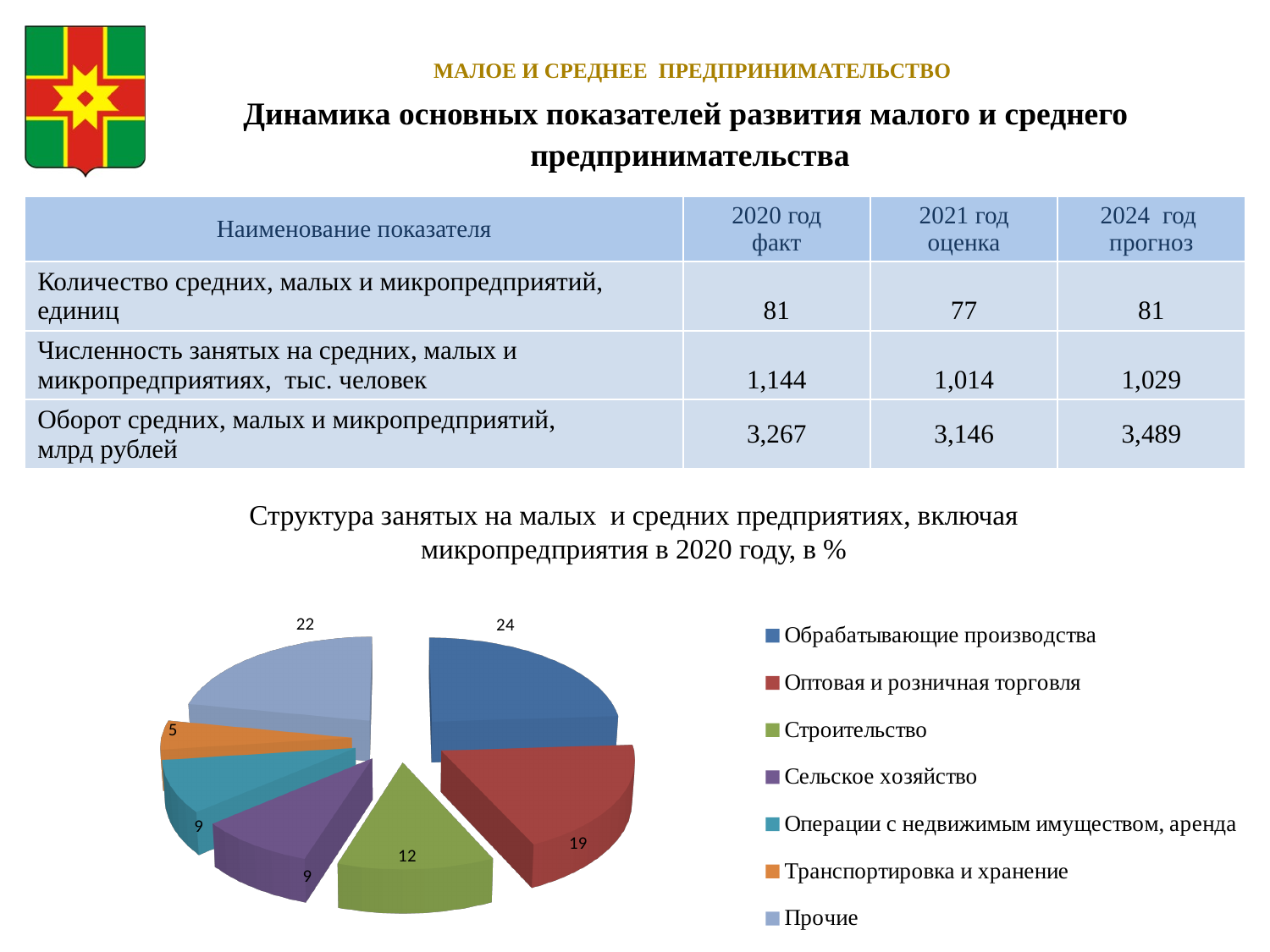
What is the value for Прочие in the pie chart? 22 How many categories does the legend of the pie chart list? 7 Which category has the largest slice in the pie chart? Обрабатывающие производства What is the value for Обрабатывающие производства in the pie chart? 24 What is the value for Строительство in the pie chart? 12 What is the title of the pie chart? Структура занятых на малых и средних предприятиях, включая микропредприятия в 2020 году, в % What is the difference between the values for Обрабатывающие производства and Оптовая и розничная торговля in the pie chart? 5 Which category has the smallest slice in the pie chart? Транспортировка и хранение What is the value for Оптовая и розничная торговля in the pie chart? 19 What is the value for Транспортировка и хранение in the pie chart? 5 Which is larger in the pie chart: Строительство or Прочие? Прочие What kind of chart is shown on the slide? pie chart